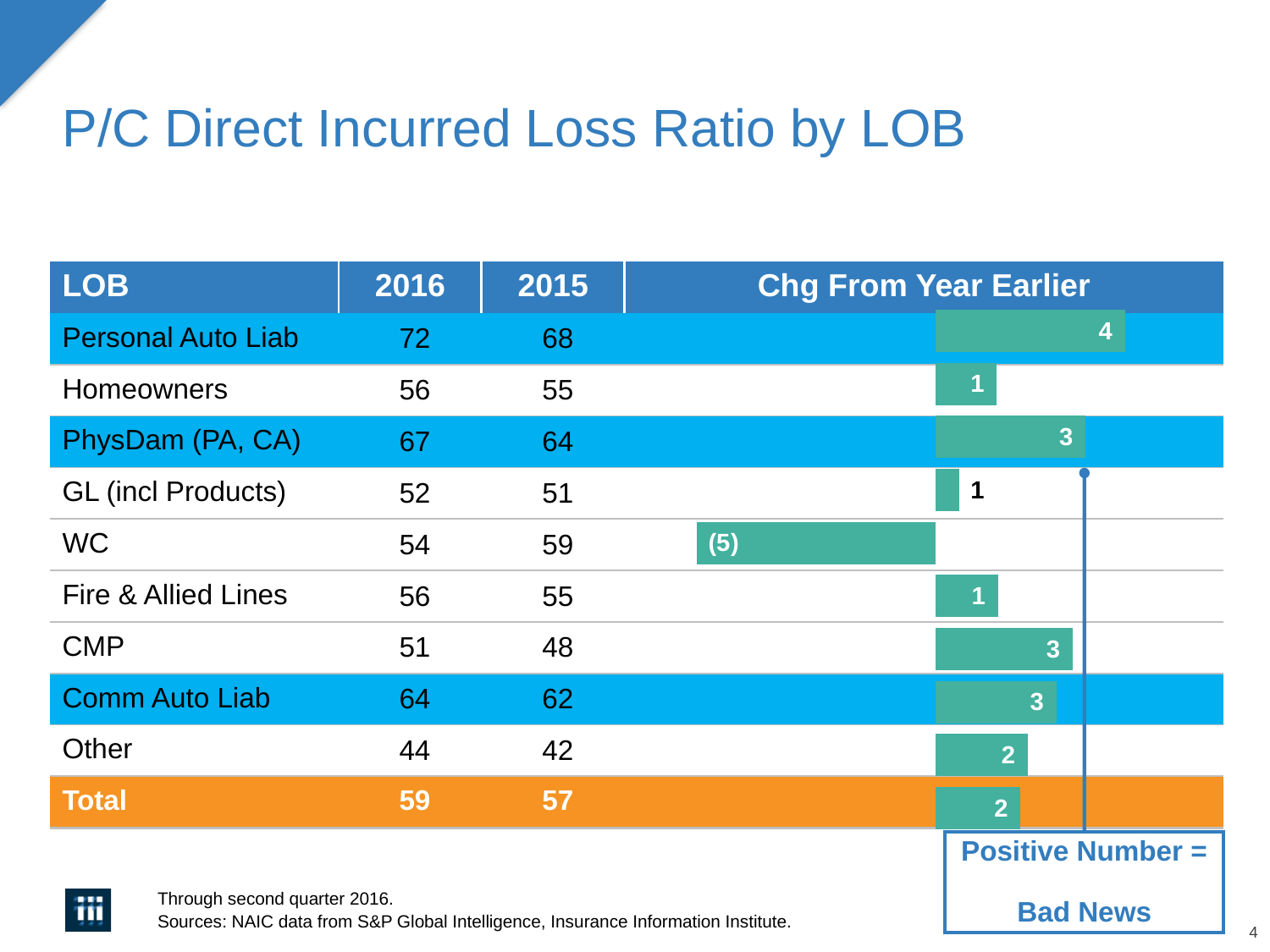
Which line of business is the only one with a negative change from a year earlier in the chart? WC What is the change from a year earlier shown for Personal Auto Liab in the 'Chg From Year Earlier' chart? 4 How many lines of business (rows) have a bar in the 'Chg From Year Earlier' chart? 10 What is the change from a year earlier shown for Other in the 'Chg From Year Earlier' chart? 2 What kind of chart is used in the 'Chg From Year Earlier' column? Bar chart In the 'Chg From Year Earlier' chart, how much larger is the change for Personal Auto Liab than for Other? 2 According to the annotation on the slide, what does a positive number in the chart mean? Bad News What is the change from a year earlier shown for WC in the 'Chg From Year Earlier' chart? (5) What is the change from a year earlier shown for Total in the 'Chg From Year Earlier' chart? 2 In the 'Chg From Year Earlier' chart, which has the larger change: CMP or Homeowners? CMP Which line of business has the lowest change from a year earlier in the 'Chg From Year Earlier' chart? WC Which line of business has the largest positive change from a year earlier in the 'Chg From Year Earlier' chart? Personal Auto Liab